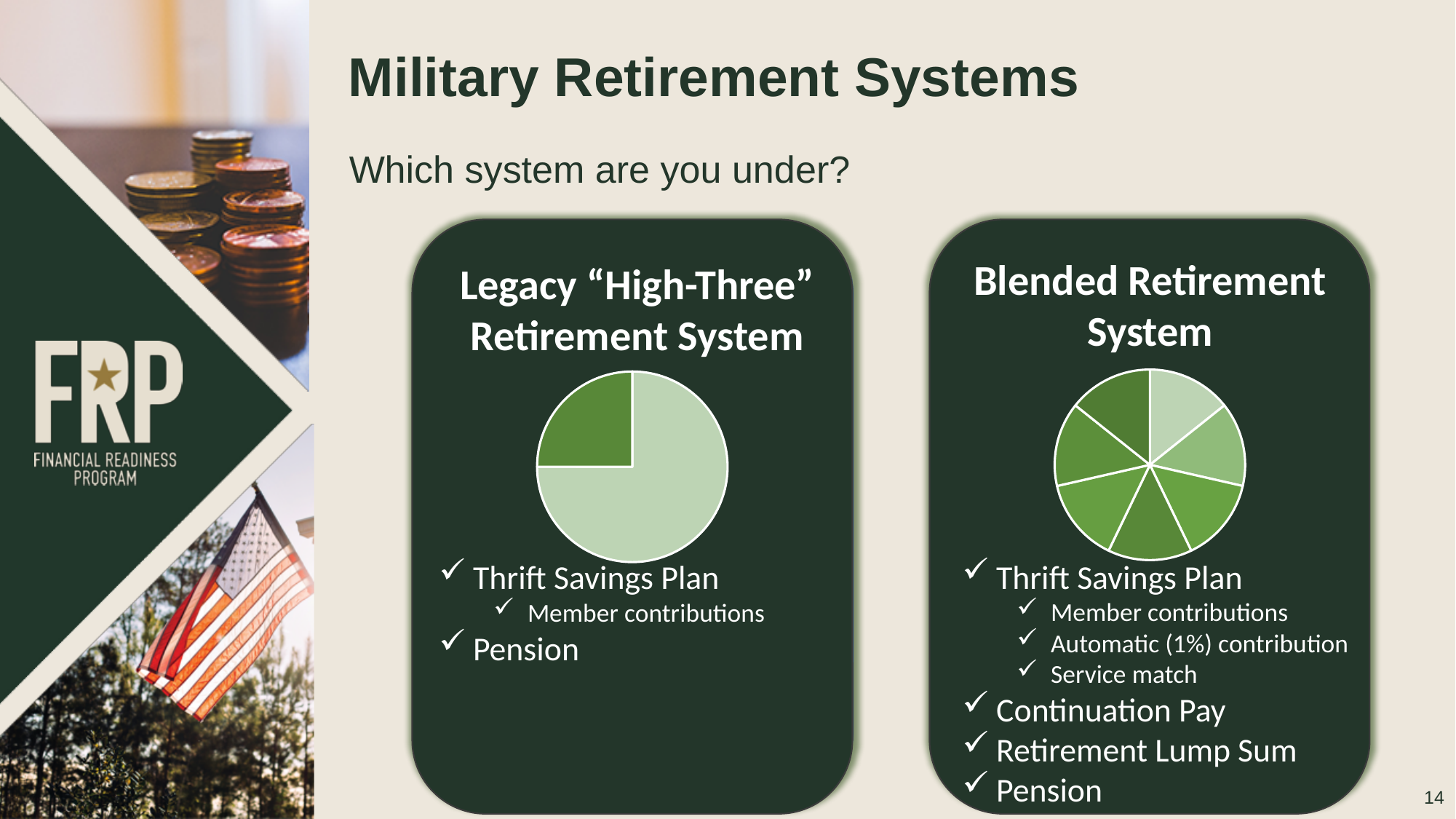
How many slices does the pie chart in the Legacy "High-Three" Retirement System box have? 2 Which of the two pie charts on the slide has more slices, the one in the Legacy "High-Three" box or the one in the Blended Retirement System box? the Blended Retirement System pie chart What is the title of the box containing the pie chart on the left? Legacy "High-Three" Retirement System In the Legacy "High-Three" Retirement System pie chart, which slice is larger, the light green one or the dark green one? the light green slice How many pie charts are shown on the slide? 2 What kind of chart is shown in the Legacy "High-Three" Retirement System box? pie chart What kind of chart is shown in the Blended Retirement System box? pie chart